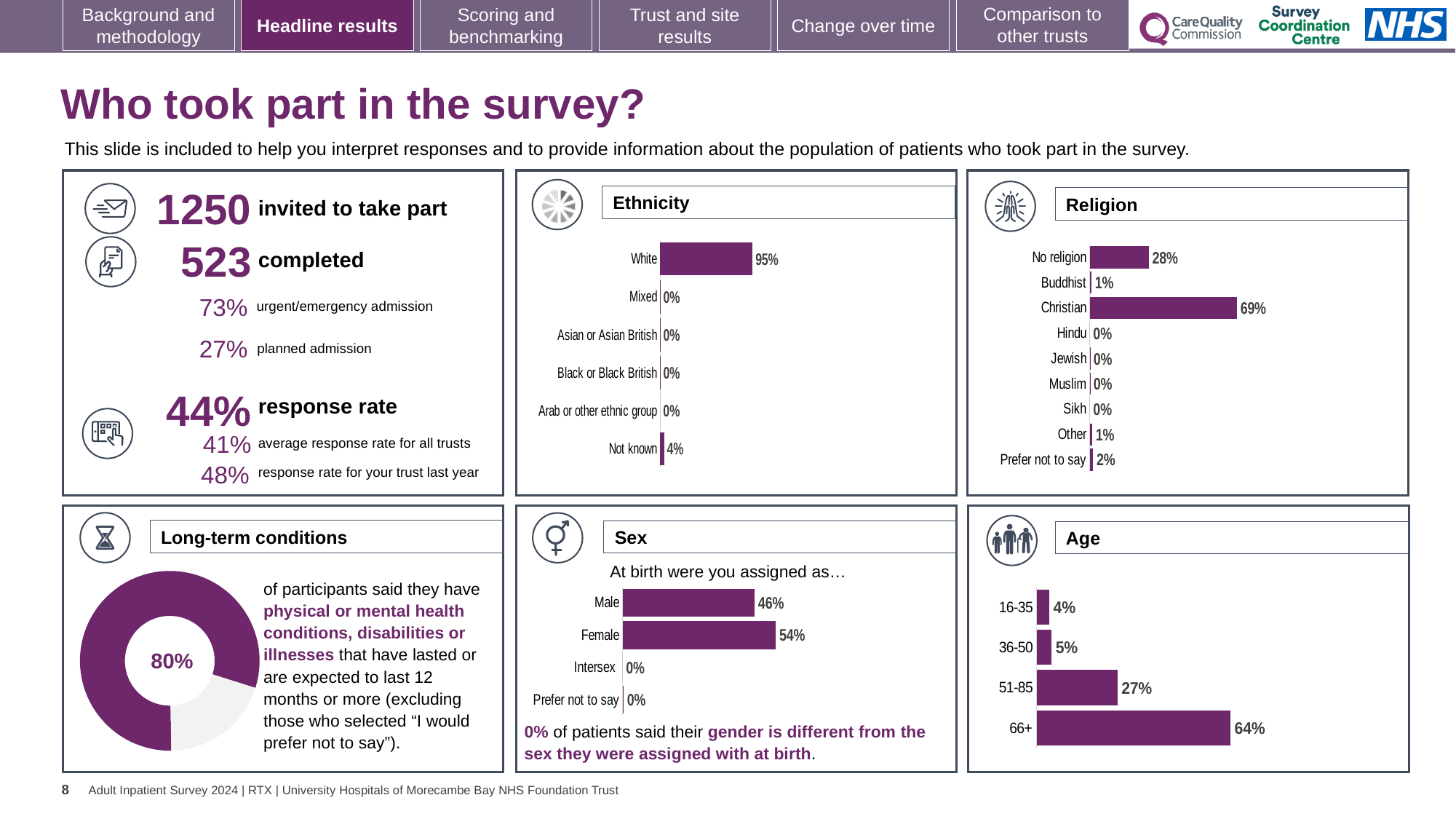
In the Ethnicity chart, what percentage of respondents had ethnicity 'Not known'? 4% In the Age chart, which age group has the highest value? 66+ What kind of chart is used in the Long-term conditions panel? doughnut chart In the Sex chart, what is the difference between the Female and Male values? 8% In the Religion chart, how many categories are shown? 9 In the Age chart, what is the value for the 51-85 age group? 27% In the Religion chart, which religion category has the highest value? Christian In the Religion chart, what is the value for 'No religion'? 28% In the Sex chart, which is larger, Male or Female? Female In the Ethnicity chart, what percentage of respondents were White? 95% In the Age chart, do the values rise or fall as the age groups get older? rise In the Religion chart, what is the difference between the Christian and No religion values? 41%